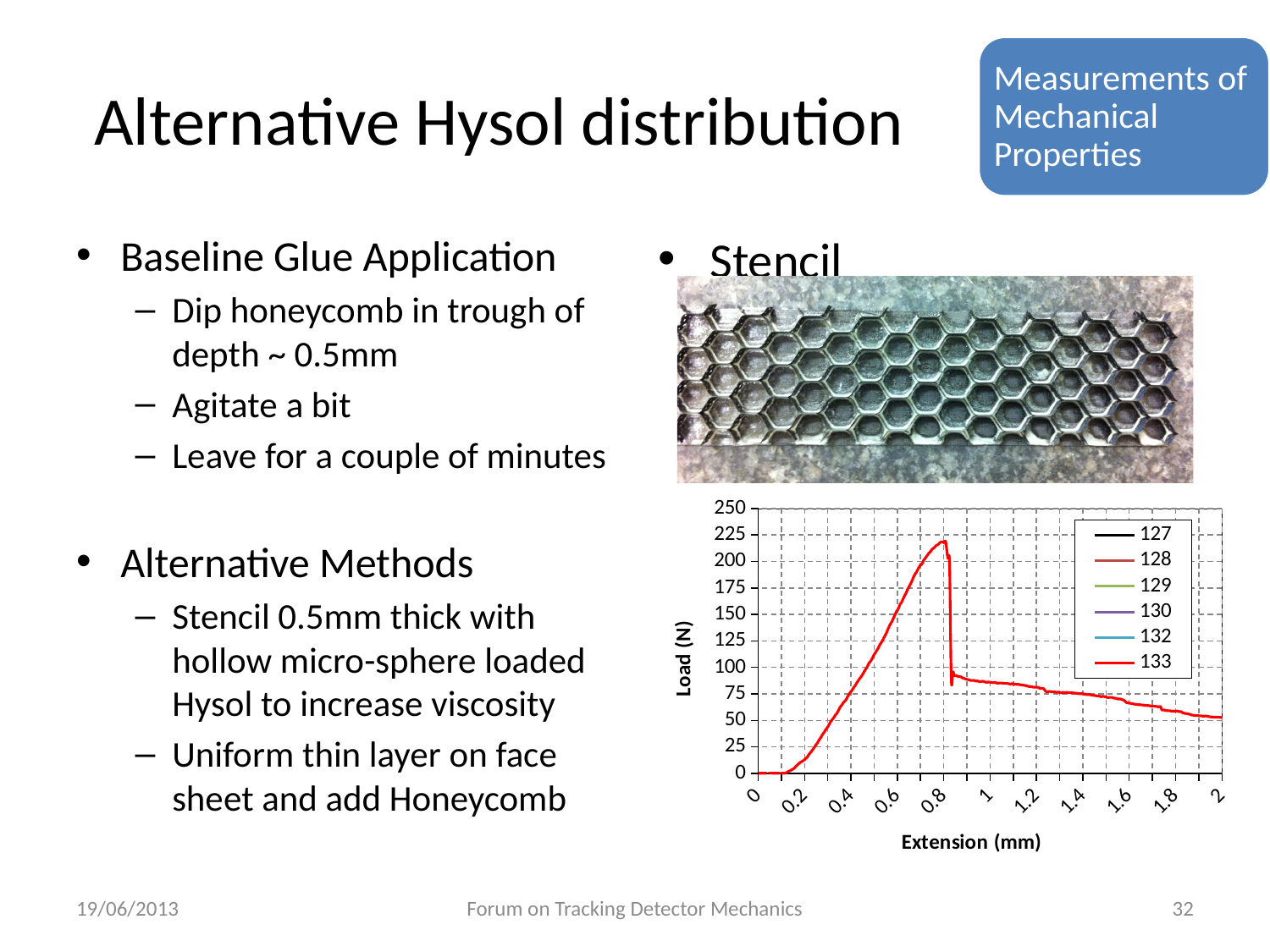
Is the load of the red line (series 133) at an extension of 1 mm greater or less than 75? greater What is the label of the chart's x axis? Extension (mm) Is the load of the red line (series 133) at an extension of 2 mm greater or less than 75? less Is the peak load reached by the red line (series 133) greater or less than 200? greater Which series in the legend is drawn in red? 133 How many series does the chart's legend list? 6 Does the load of the red line (series 133) rise or fall as extension increases from 1 mm to 2 mm? fall Does the load of the red line (series 133) rise or fall as extension increases from 0 to 0.8 mm? rise What kind of chart is shown on the slide? line chart What is the label of the chart's y axis? Load (N)